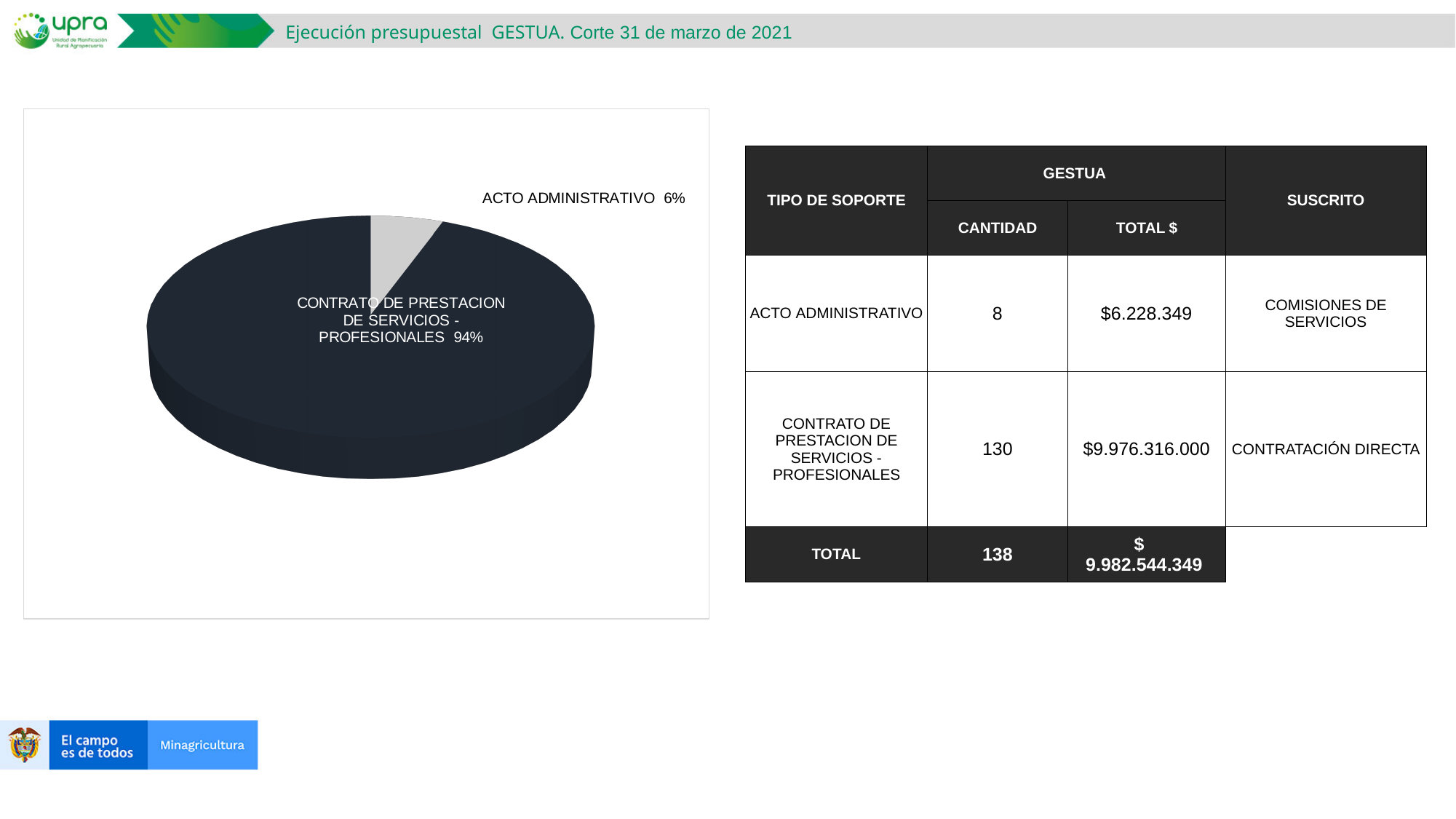
What is the difference in percentage points between the CONTRATO DE PRESTACION DE SERVICIOS - PROFESIONALES slice and the ACTO ADMINISTRATIVO slice? 88 percentage points Which slice of the pie is the smallest? ACTO ADMINISTRATIVO What share of the pie does ACTO ADMINISTRATIVO represent? 6% What kind of chart is shown on the slide? Pie chart Is the pie chart drawn in 3D or flat 2D? 3D Which is larger in the pie chart: ACTO ADMINISTRATIVO or CONTRATO DE PRESTACION DE SERVICIOS - PROFESIONALES? CONTRATO DE PRESTACION DE SERVICIOS - PROFESIONALES What colour is the ACTO ADMINISTRATIVO slice of the pie? Light grey Which slice of the pie is the largest? CONTRATO DE PRESTACION DE SERVICIOS - PROFESIONALES How many slices does the pie chart have? 2 What share of the pie does CONTRATO DE PRESTACION DE SERVICIOS - PROFESIONALES represent? 94%